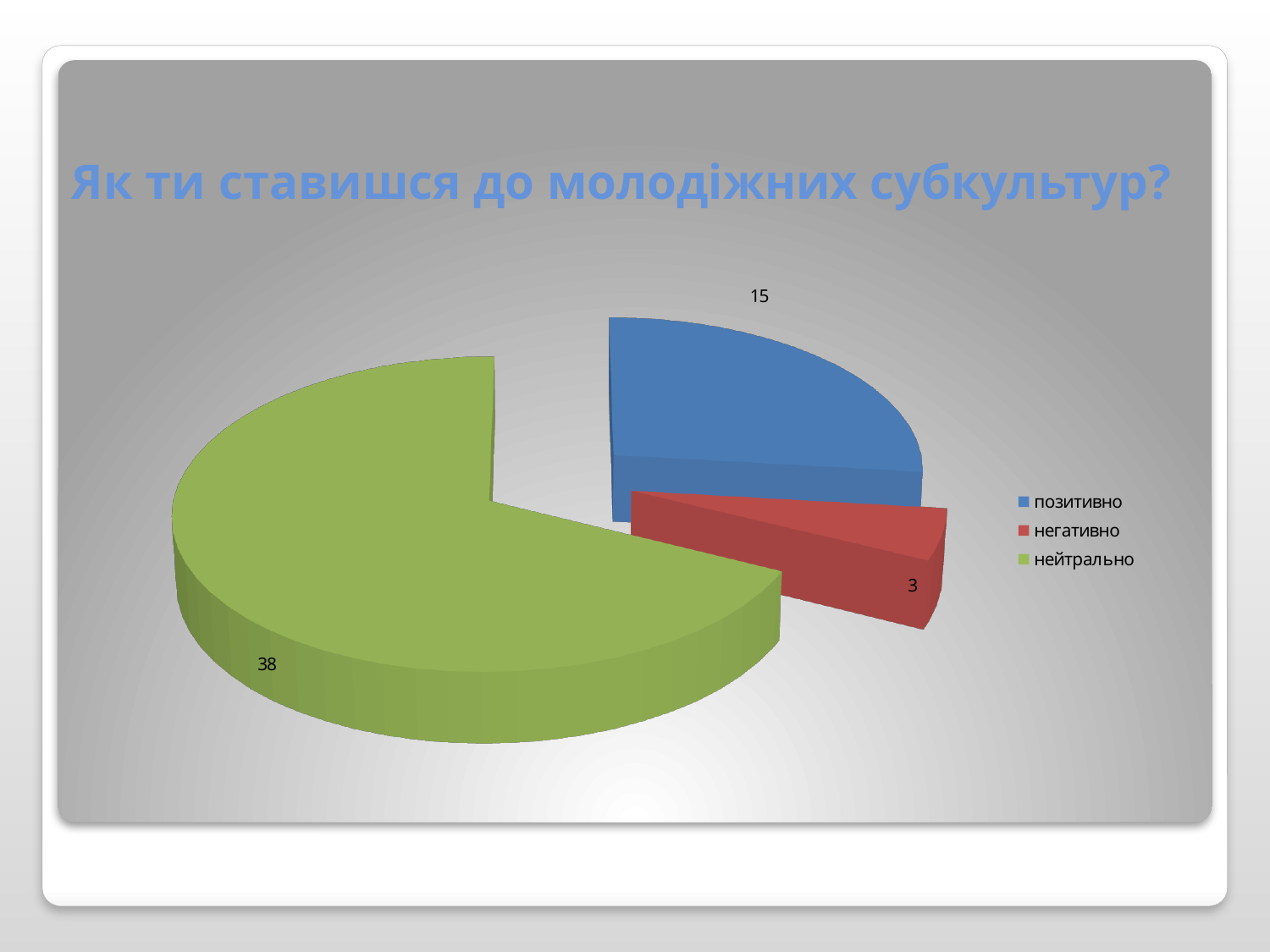
What is the value for нейтрально? 38 How many slices does the pie chart have? 3 What is the value for негативно? 3 What is the difference between the values for нейтрально and позитивно? 23 Which category has the lowest value? негативно What colour is the slice for негативно? red What is the value for позитивно? 15 What is the difference between the values for позитивно and негативно? 12 What is the total of all slices in the pie chart? 56 Which category has the highest value? нейтрально Which is larger, the value for позитивно or the value for негативно? позитивно What kind of chart is shown on the slide? pie chart